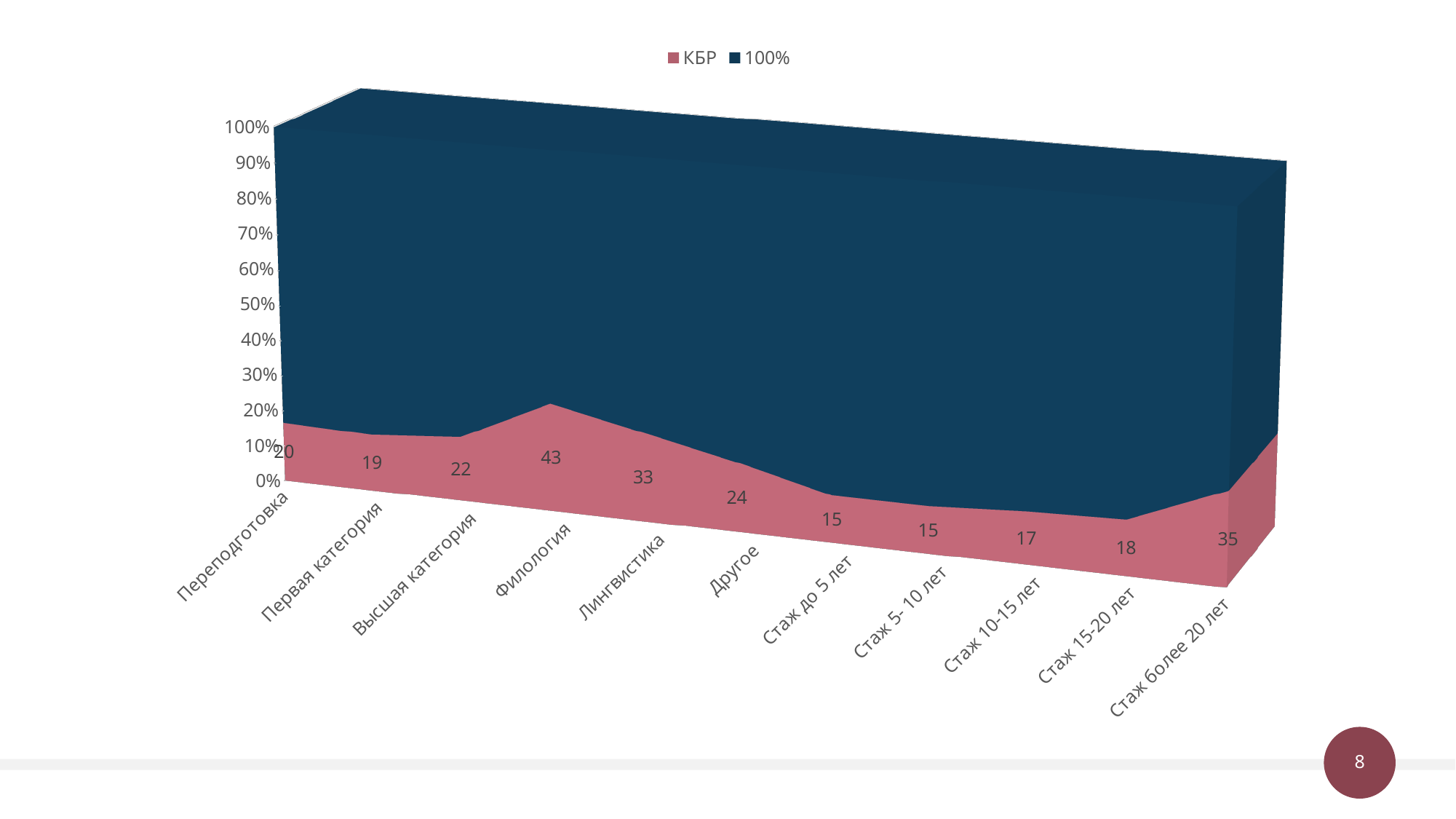
Which category has the highest КБР value? Филология What is the КБР value for Филология? 43 How many categories are shown on the x axis? 11 What is the difference between the КБР values for Филология and Лингвистика? 10 What is the КБР value for Первая категория? 19 What is the КБР value for Стаж более 20 лет? 35 Do the КБР values rise or fall from Стаж до 5 лет to Стаж более 20 лет? Rise Which has a larger КБР value, Другое or Высшая категория? Другое What is the difference between the КБР values for Стаж более 20 лет and Стаж 15-20 лет? 17 What kind of chart is shown on the slide? Area chart What is the КБР value for Стаж 10-15 лет? 17 How many series does the legend list? 2